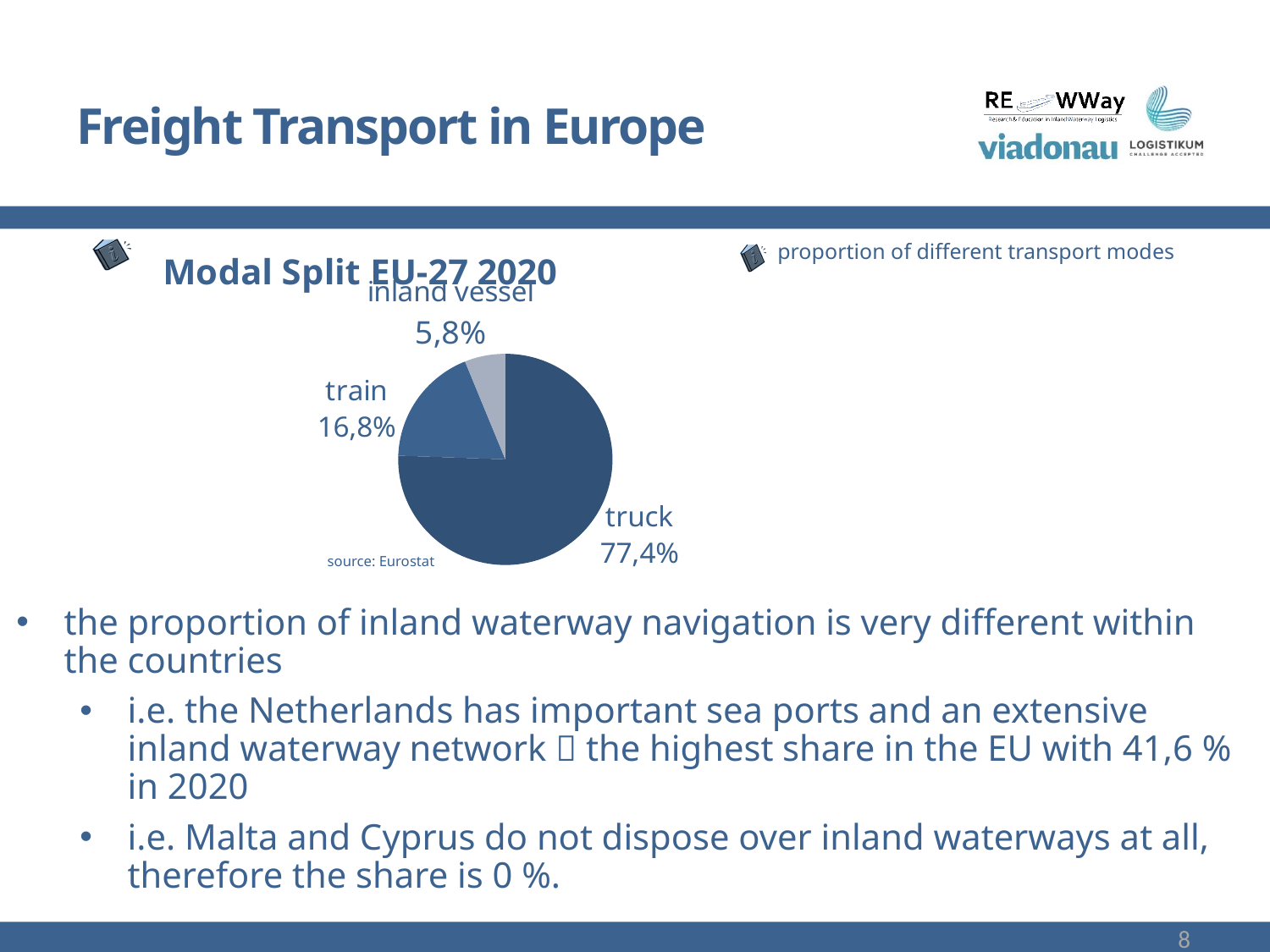
What type of chart is shown on the slide? pie chart What source is cited below the pie chart? Eurostat Which transport mode has the largest share in the pie chart? truck What is the difference between the train share and the inland vessel share? 11,0% What is the value shown for train? 16,8% What is the title of the chart? Modal Split EU-27 2020 How many slices does the pie chart have? 3 What share of the pie does truck account for? 77,4% What is the difference between the truck share and the train share? 60,6% Which is larger, the share for train or the share for inland vessel? train What is the value shown for inland vessel? 5,8% Which transport mode has the smallest share in the pie chart? inland vessel